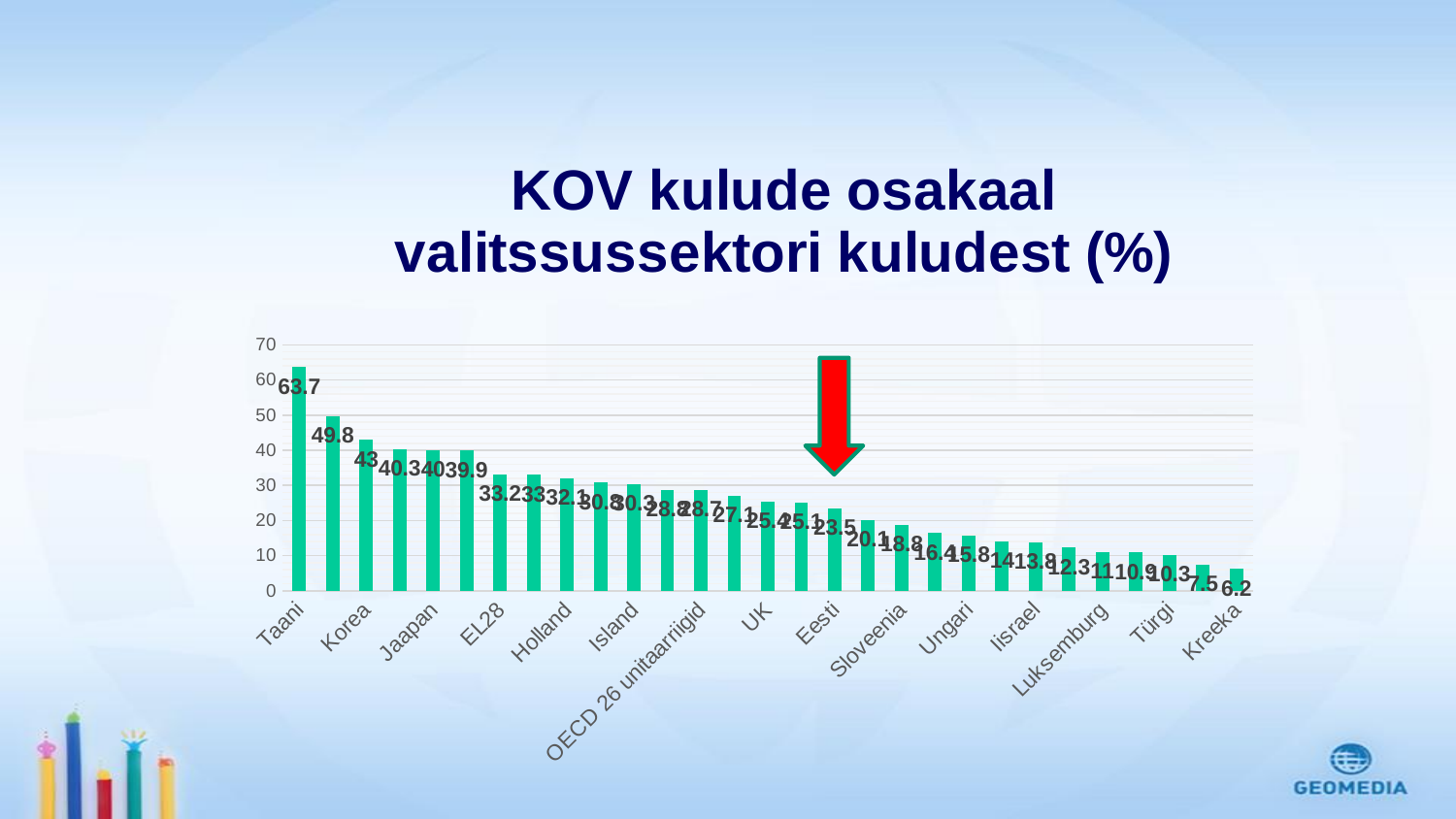
What is the difference between the values for Taani and Kreeka? 57.5 What is the value for Kreeka? 6.2 Is the value for Taani greater or less than 60? greater What kind of chart is shown on the slide? bar chart Do the values rise or fall from left to right along the x axis? fall Which country has the lowest value in the chart? Kreeka Which country has the highest value in the chart? Taani What is the title of the chart? KOV kulude osakaal valitssussektori kuludest (%) What is the value for Taani? 63.7 What is the value for Eesti? 23.5 Which is larger, the value for Korea or the value for Eesti? Korea Is the value for Eesti greater or less than 30? less